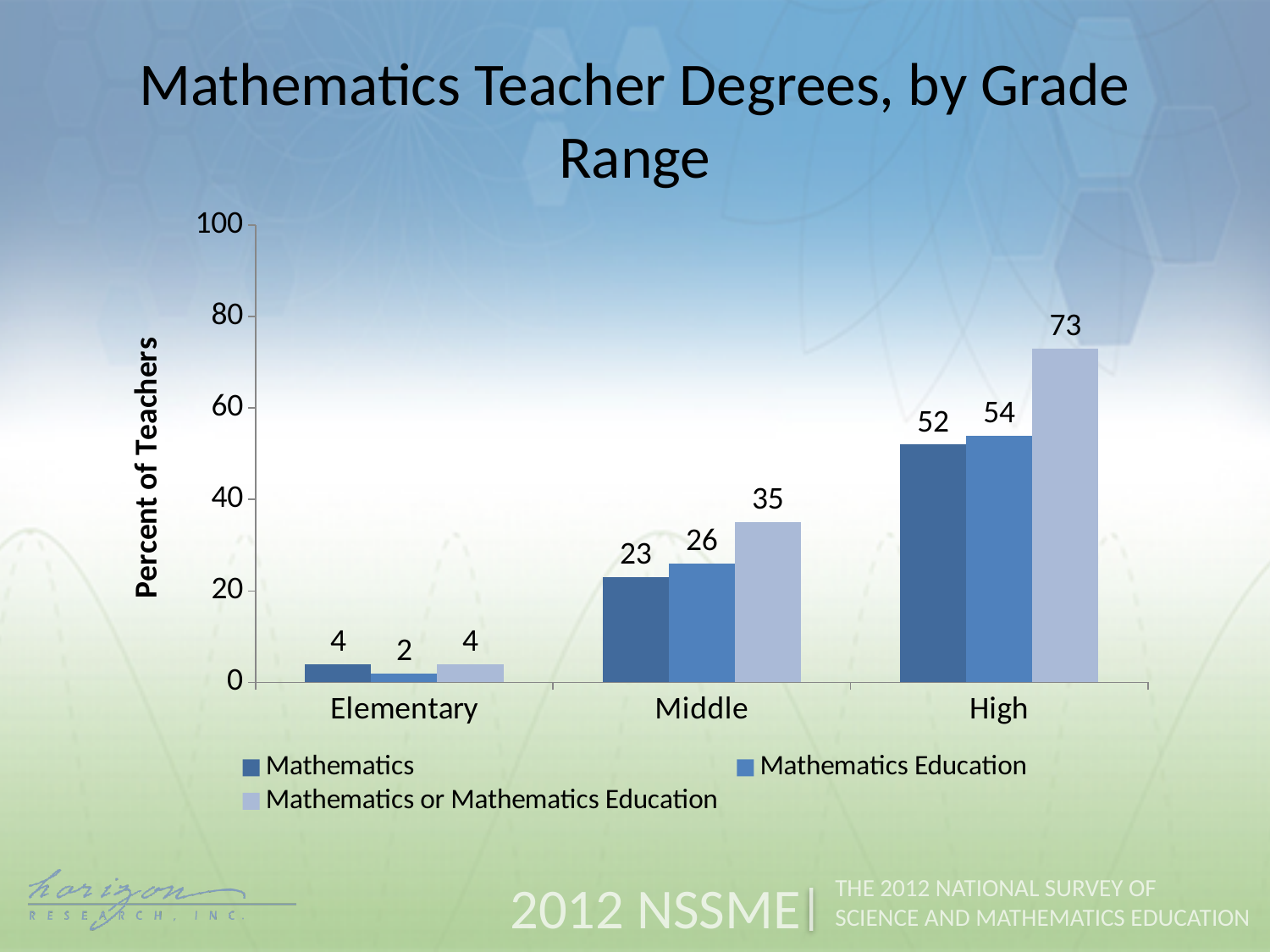
In the High grade range, which is larger: Mathematics or Mathematics Education? Mathematics Education What is the value for Mathematics in the Elementary grade range? 4 What is the value for Mathematics or Mathematics Education in the High grade range? 73 What is the label of the y axis? Percent of Teachers Which grade range has the highest value for the Mathematics series? High How many series does the legend list? 3 Is the value for Mathematics in the High grade range greater or less than 40? greater What is the value for Mathematics Education in the Middle grade range? 26 What is the difference between the Mathematics or Mathematics Education values for High and Middle? 38 What kind of chart is shown on the slide? Bar chart Which grade range has the lowest value for the Mathematics Education series? Elementary How many grade range categories are shown on the x axis? 3